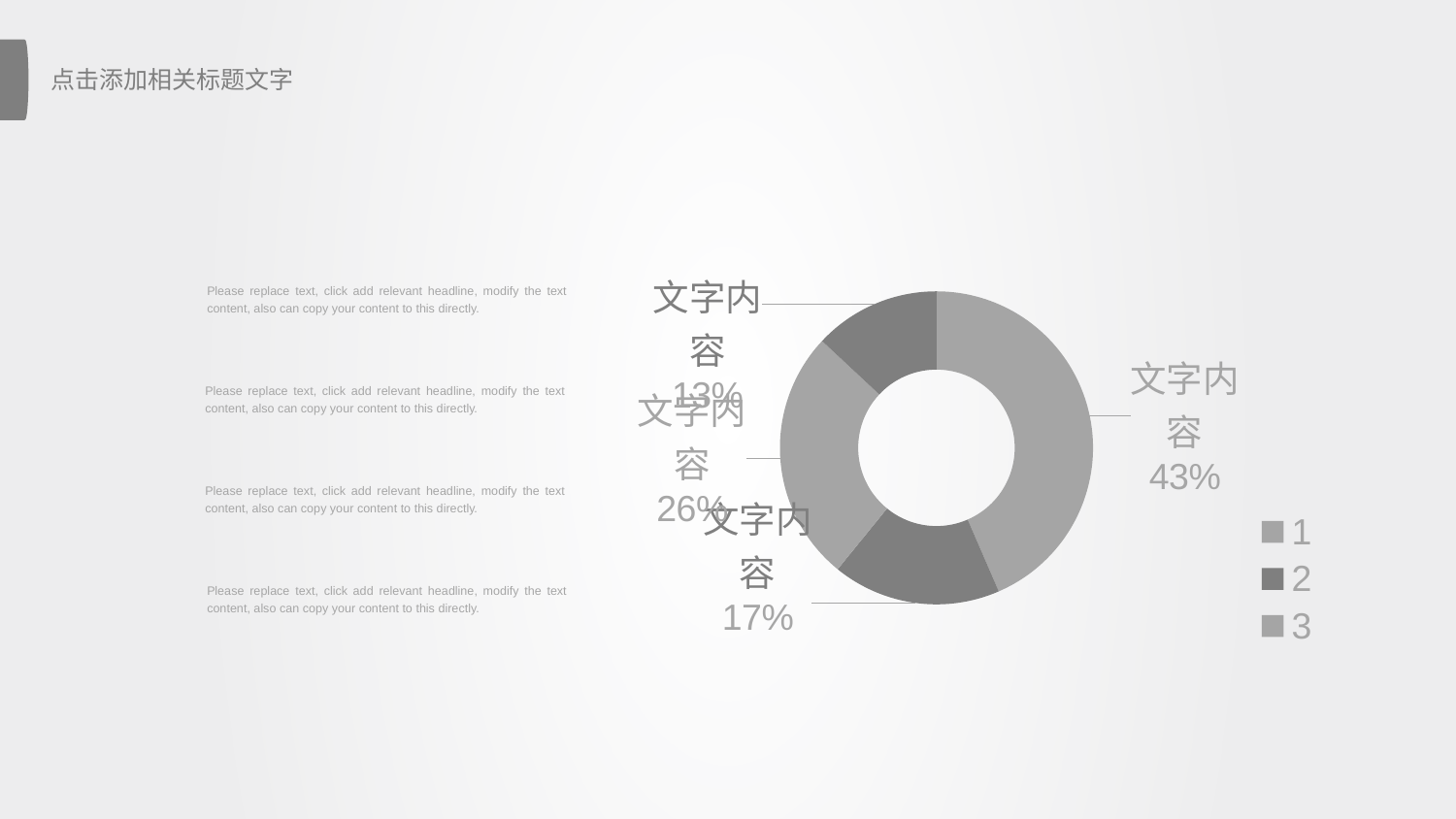
What percentage is labelled on the slice on the right side of the doughnut? 43% What are the entries shown in the legend? 1, 2, 3 What is the largest percentage shown on the doughnut chart? 43% How many slices does the doughnut chart have? 4 What percentage is labelled on the slice at the bottom of the doughnut? 17% Which is larger, the slice on the left side of the doughnut or the slice at the bottom? the slice on the left side (26%) What is the smallest percentage shown on the doughnut chart? 13% What kind of chart is shown on the slide? doughnut chart What percentage is labelled on the slice on the left side of the doughnut? 26% How many entries does the legend list? 3 What percentage is labelled on the darkest slice at the top-left of the doughnut? 13% What is the difference in percentage points between the largest slice (43%) and the 17% slice? 26